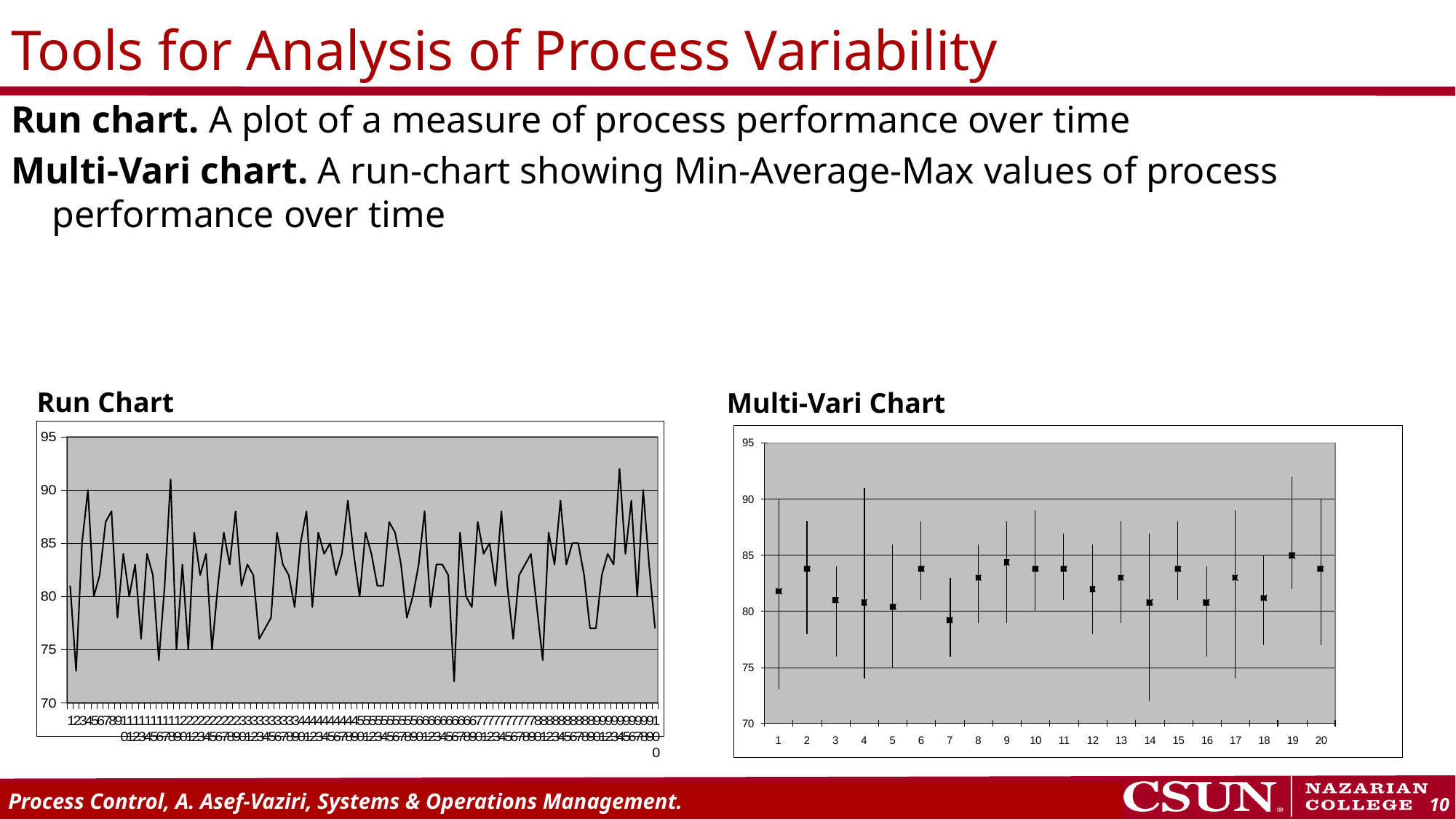
In the Multi-Vari Chart, is the maximum value for period 19 greater or less than 90? greater In the Multi-Vari Chart, how many time periods are shown on the x axis? 20 What is the highest value shown on the y axis of the Run Chart? 95 In the Multi-Vari Chart, is the average value for period 9 greater or less than 80? greater In the Multi-Vari Chart, is the average value for period 7 greater or less than 80? less In the Multi-Vari Chart, which period has the lowest average marker? 7 In the Multi-Vari Chart, is the average for period 9 larger or smaller than the average for period 7? larger What is the lowest value shown on the y axis of the Multi-Vari Chart? 70 What kind of chart is the Run Chart on the left of the slide? line chart